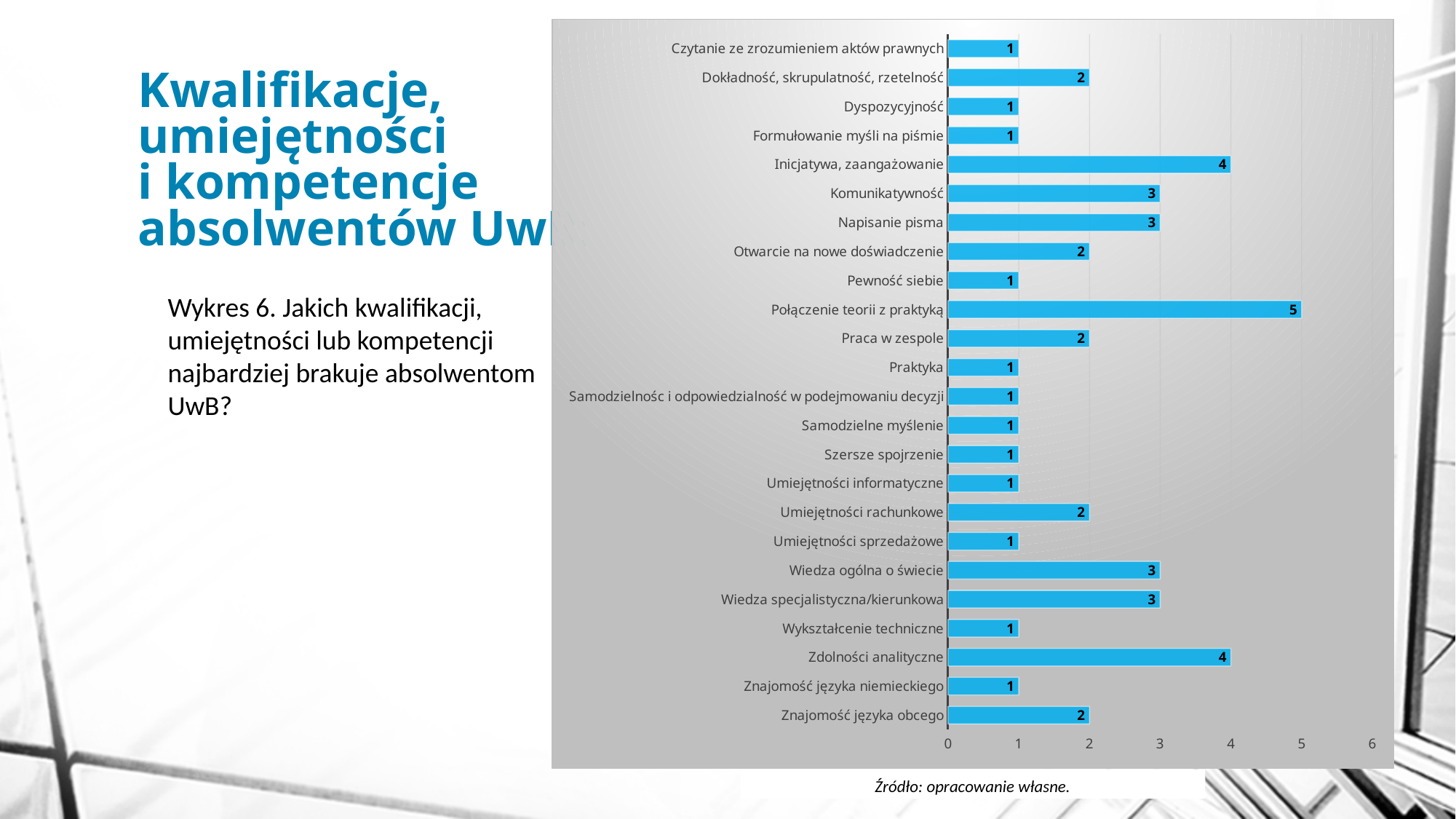
What kind of chart is shown on the slide? Bar chart What is the value for Zdolności analityczne? 4 What is the value for Znajomość języka obcego? 2 What is the value for Połączenie teorii z praktyką? 5 What is the value for Komunikatywność? 3 Which category has the highest value? Połączenie teorii z praktyką How many categories are shown in the chart? 24 What is the difference between the values for Połączenie teorii z praktyką and Inicjatywa, zaangażowanie? 1 What is the highest value shown on the horizontal axis of the chart? 6 Which is larger, the value for Wiedza ogólna o świecie or the value for Umiejętności rachunkowe? Wiedza ogólna o świecie What is the difference between the values for Zdolności analityczne and Praca w zespole? 2 Which is larger, the value for Dyspozycyjność or the value for Dokładność, skrupulatność, rzetelność? Dokładność, skrupulatność, rzetelność